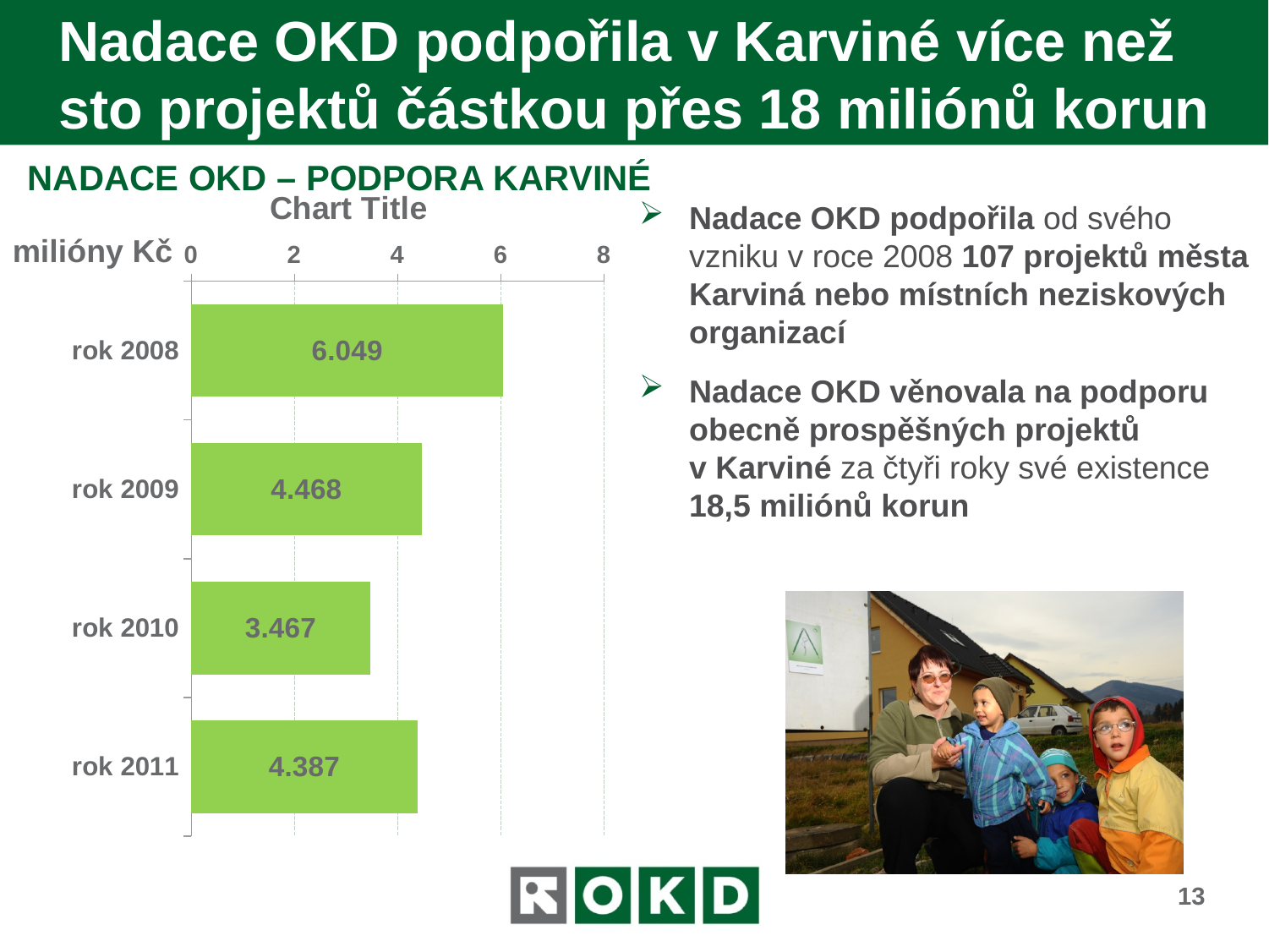
What is the difference between the values for rok 2008 and rok 2009? 1.581 How many years are shown in the chart? 4 What is the value for rok 2011? 4.387 What is the difference between the values for rok 2009 and rok 2010? 1.001 Which is larger, the value for rok 2008 or the value for rok 2011? rok 2008 Which year has the lowest value? rok 2010 Is the value for rok 2008 greater or less than 4? greater What kind of chart is shown on the slide? bar chart What is the value for rok 2010? 3.467 What unit is given for the values in the chart? milióny Kč Which year has the highest value? rok 2008 What is the value for rok 2008? 6.049